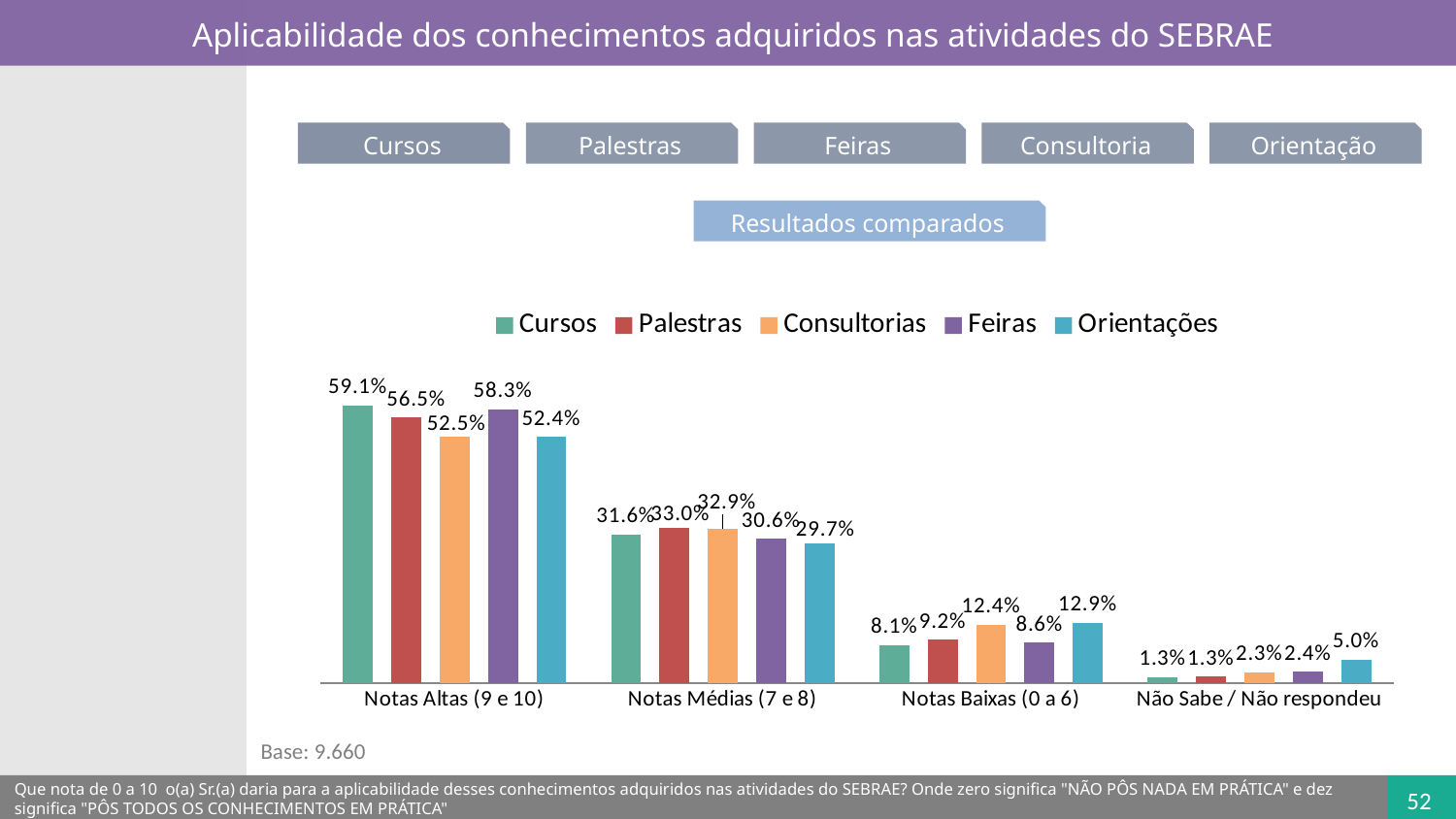
What is the base (number of respondents) shown below the chart? 9.660 Which series has the lowest value in the Notas Baixas (0 a 6) category? Cursos What is the value for Cursos in the Notas Altas (9 e 10) category? 59.1% How many categories are shown on the x axis? 4 What is the difference between Cursos and Orientações in the Notas Altas (9 e 10) category? 6.7% What is the value for Feiras in the Notas Médias (7 e 8) category? 30.6% Which is larger in the Notas Baixas (0 a 6) category: Palestras or Orientações? Orientações What kind of chart is shown on the slide? Bar chart What is the value for Orientações in the Não Sabe / Não respondeu category? 5.0% What is the value for Consultorias in the Notas Baixas (0 a 6) category? 12.4% Which series has the highest value in the Notas Altas (9 e 10) category? Cursos How many series does the legend list? 5